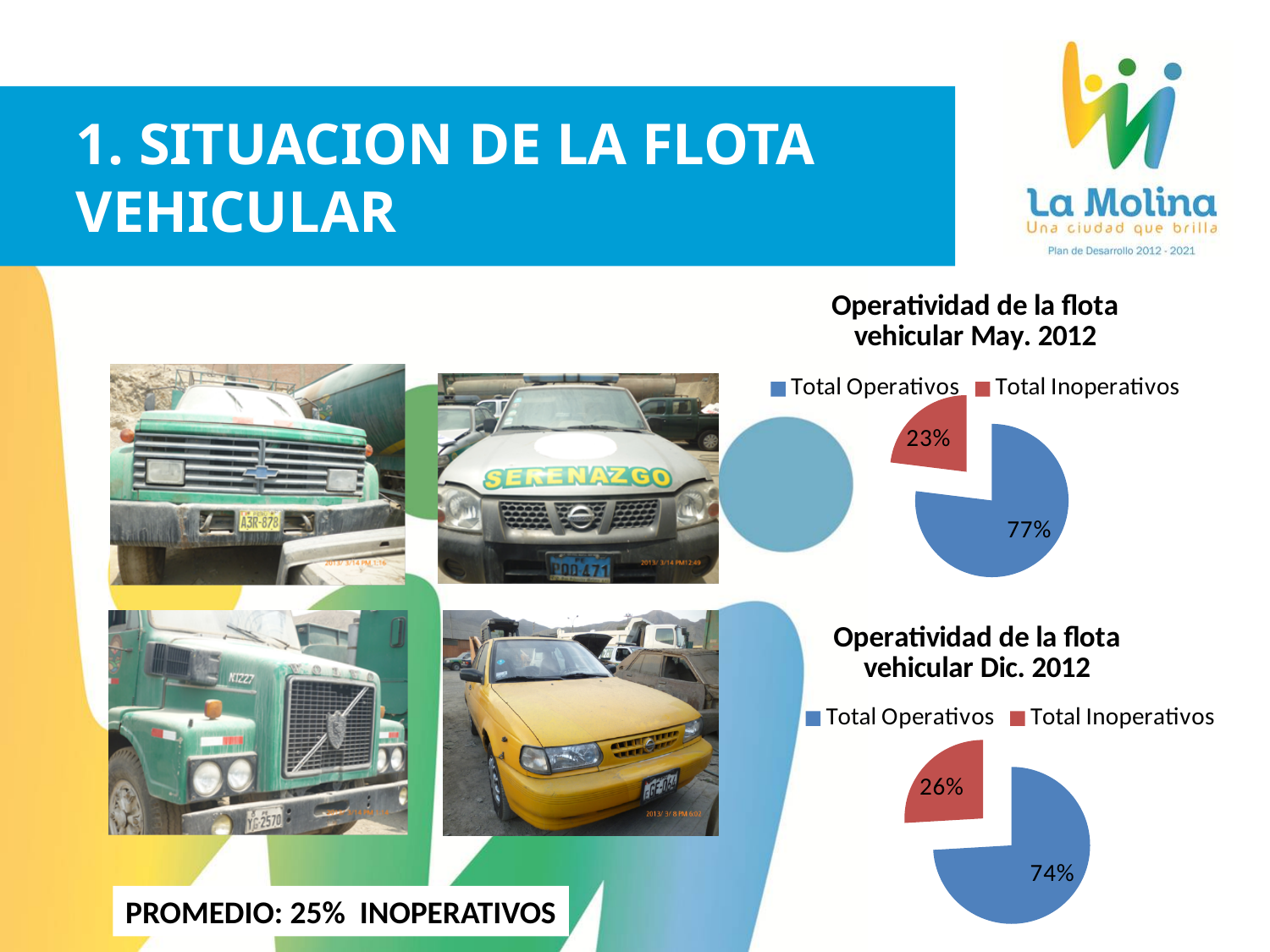
In the 'Operatividad de la flota vehicular Dic. 2012' chart, what share is Total Operativos? 74% In the 'Operatividad de la flota vehicular May. 2012' chart, what colour is the Total Inoperativos slice? Red In the 'Operatividad de la flota vehicular May. 2012' chart, what is the difference between Total Operativos and Total Inoperativos? 54% Which chart shows a larger Total Inoperativos share, May. 2012 or Dic. 2012? Dic. 2012 In the 'Operatividad de la flota vehicular Dic. 2012' chart, which category has the largest slice? Total Operativos What kind of chart is 'Operatividad de la flota vehicular May. 2012'? Pie chart How many series does the legend of the 'Operatividad de la flota vehicular Dic. 2012' chart list? 2 In the 'Operatividad de la flota vehicular Dic. 2012' chart, what is the difference between Total Operativos and Total Inoperativos? 48% In the 'Operatividad de la flota vehicular May. 2012' chart, which category has the smallest slice? Total Inoperativos In the 'Operatividad de la flota vehicular May. 2012' chart, what share is Total Operativos? 77% In the 'Operatividad de la flota vehicular May. 2012' chart, what share is Total Inoperativos? 23% In the 'Operatividad de la flota vehicular Dic. 2012' chart, what share is Total Inoperativos? 26%